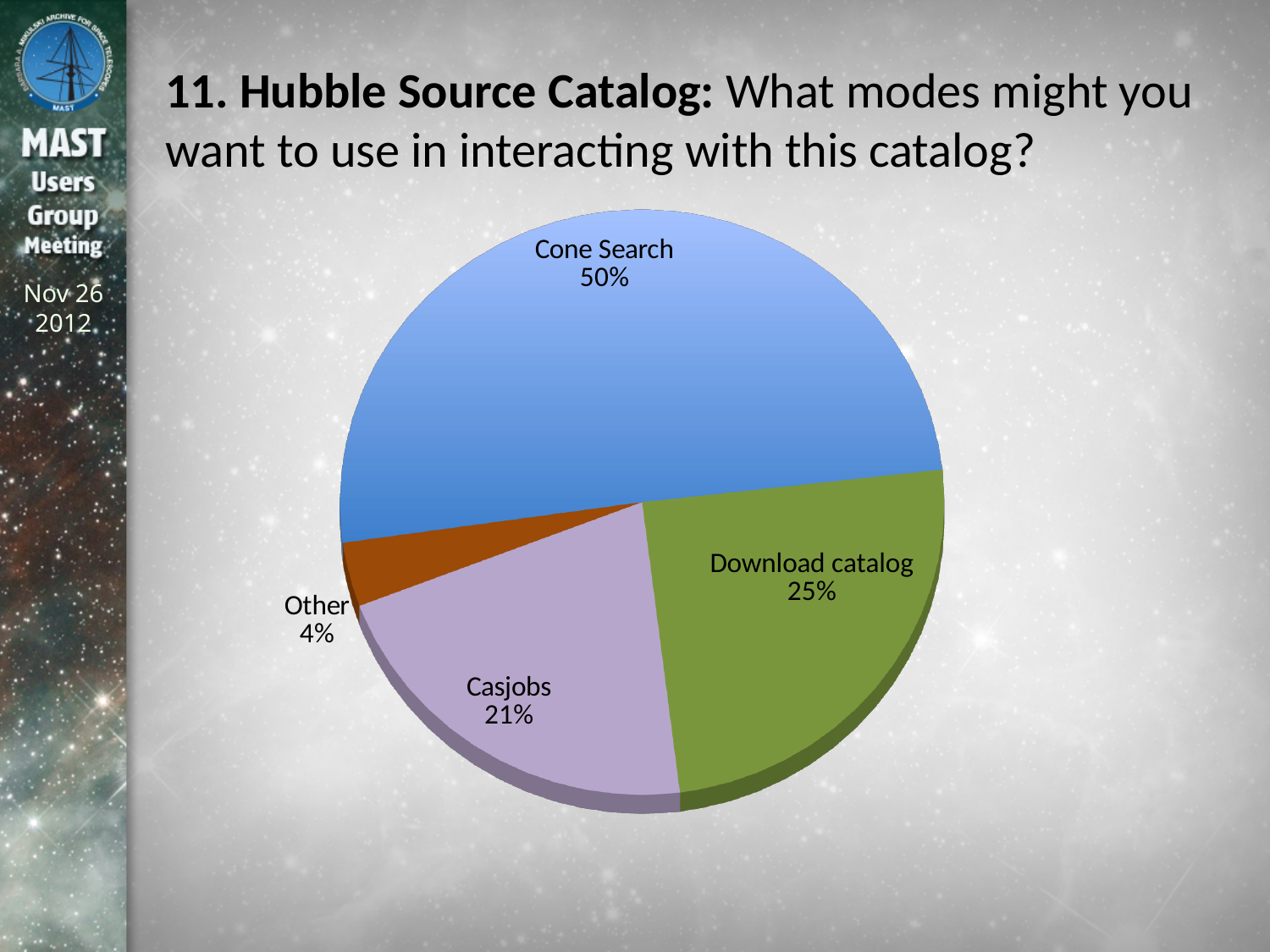
What share of the pie does Casjobs have? 21% Which slice of the pie is the smallest? Other What kind of chart is shown on the slide? pie chart What is the difference in percentage points between Download catalog and Casjobs? 4 What is the difference in percentage points between Cone Search and Download catalog? 25 What share of the pie does Other have? 4% How many slices does the pie chart have? 4 What share of the pie does Cone Search have? 50% What colour is the Cone Search slice? blue Which is larger, the Casjobs slice or the Download catalog slice? Download catalog Which slice of the pie is the largest? Cone Search